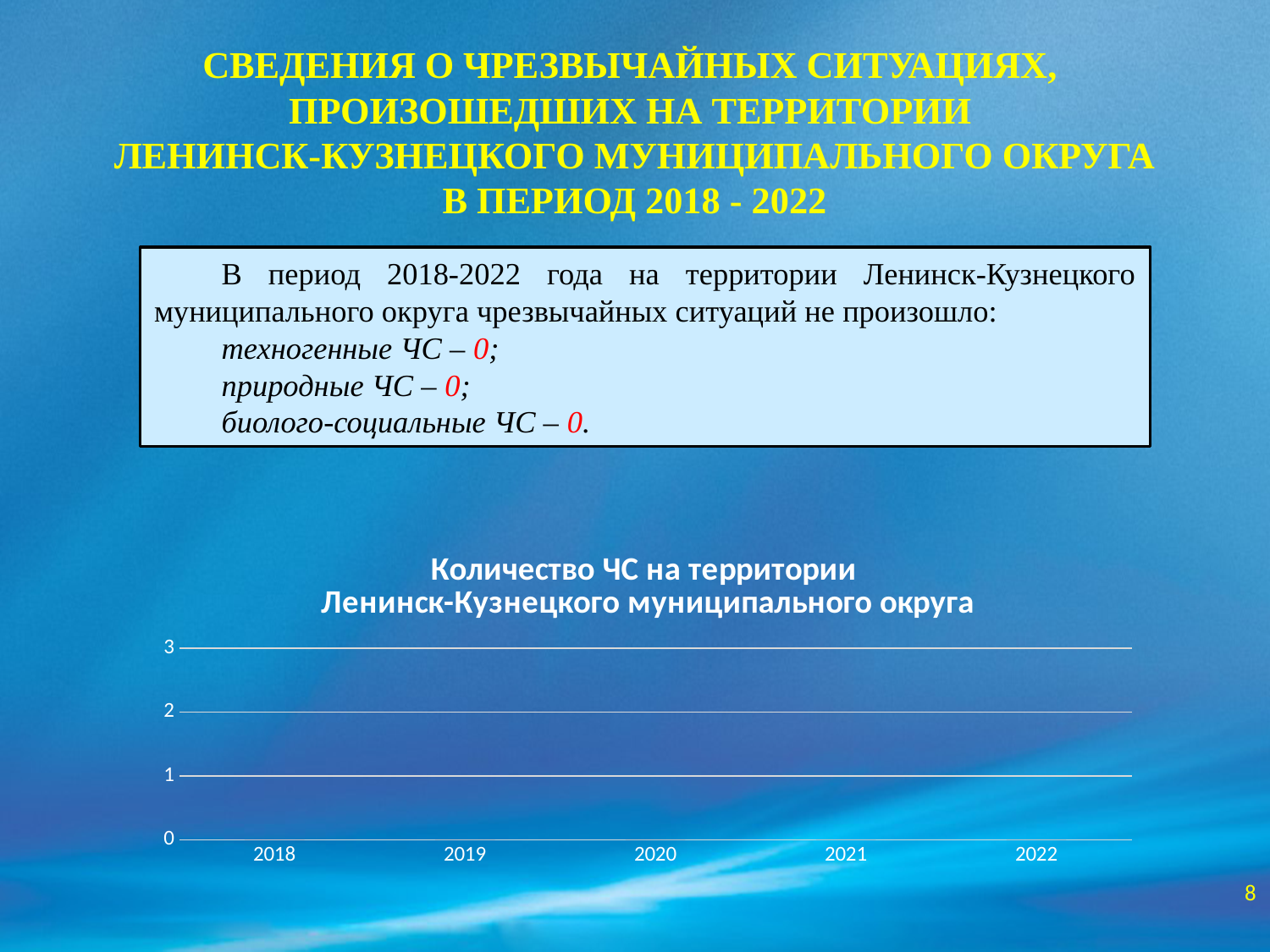
Is the value for 2022 in the chart greater or less than 1? less Is the value for 2018 in the chart greater or less than 2? less According to the slide, how many emergencies (ЧС) occurred in the Ленинск-Кузнецкий municipal district in 2019? 0 What is the title of the chart on the slide? Количество ЧС на территории Ленинск-Кузнецкого муниципального округа Is the value for 2020 in the chart greater or less than 1? less According to the slide, how many emergencies (ЧС) occurred in the Ленинск-Кузнецкий municipal district in 2021? 0 What is the highest value shown on the y axis of the chart? 3 What is the first year shown on the x axis of the chart? 2018 Do the values in the chart rise, fall or stay the same from 2018 to 2022? stay the same How many years are shown on the x axis of the chart? 5